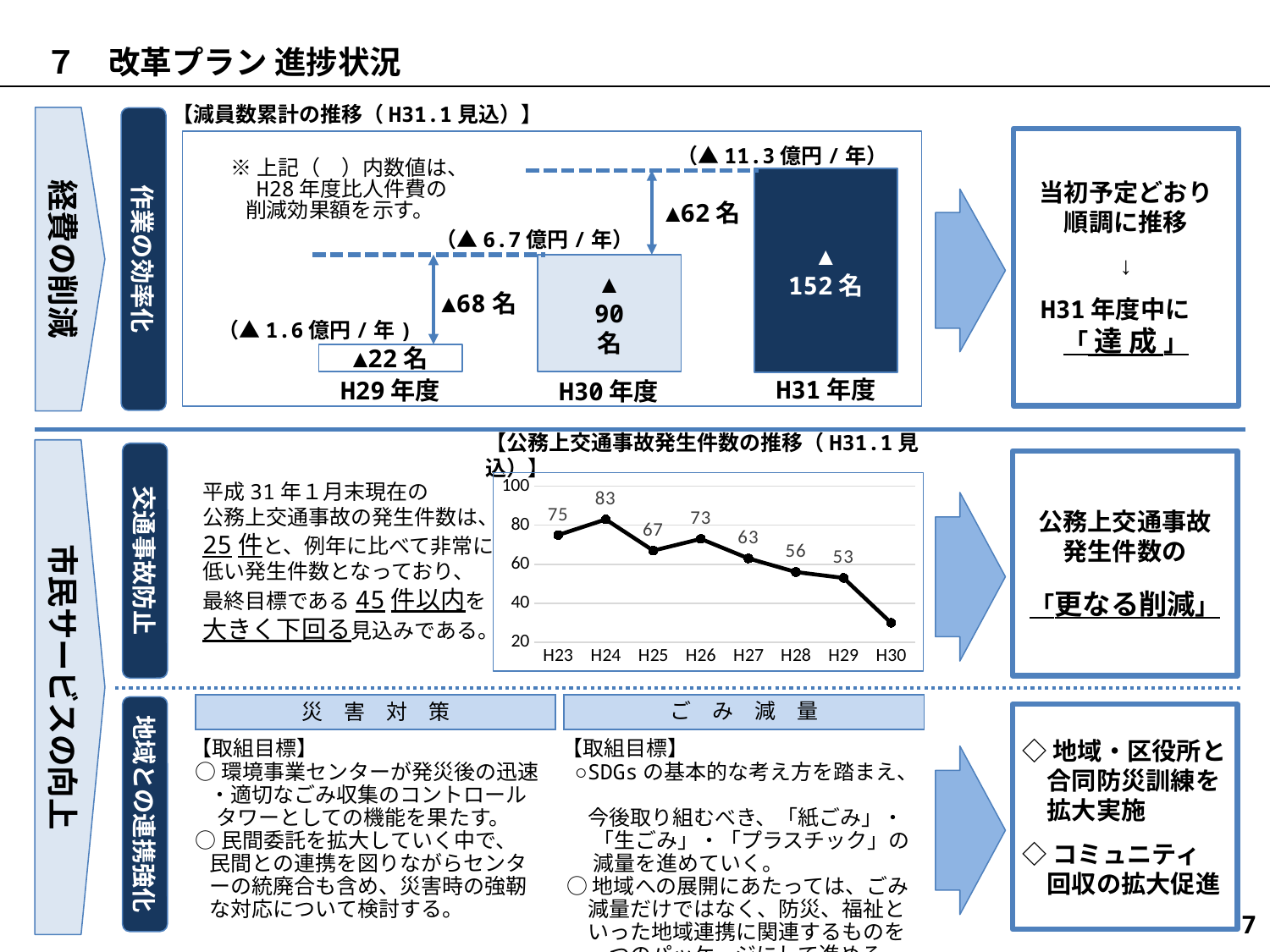
In the 公務上交通事故発生件数の推移 chart, is the value for H30 greater or less than 40? less In the 公務上交通事故発生件数の推移 chart, which year has the highest value? H24 In the 減員数累計の推移 chart, what is the value shown for H31年度? ▲152名 In the 減員数累計の推移 chart, how many fiscal years are shown? 3 In the 減員数累計の推移 chart, what is the value shown for H30年度? ▲90名 In the 公務上交通事故発生件数の推移 chart, what is the difference between the H25 and H26 values? 6 What kind of chart is the 減員数累計の推移 chart? bar chart In the 公務上交通事故発生件数の推移 chart, what is the value for H24? 83 In the 減員数累計の推移 chart, which fiscal year has the smallest value? H29年度 In the 公務上交通事故発生件数の推移 chart, how many years are plotted on the x axis? 8 In the 減員数累計の推移 chart, what is the difference between the H31年度 and H30年度 values? 62名 In the 公務上交通事故発生件数の推移 chart, what is the value for H28? 56